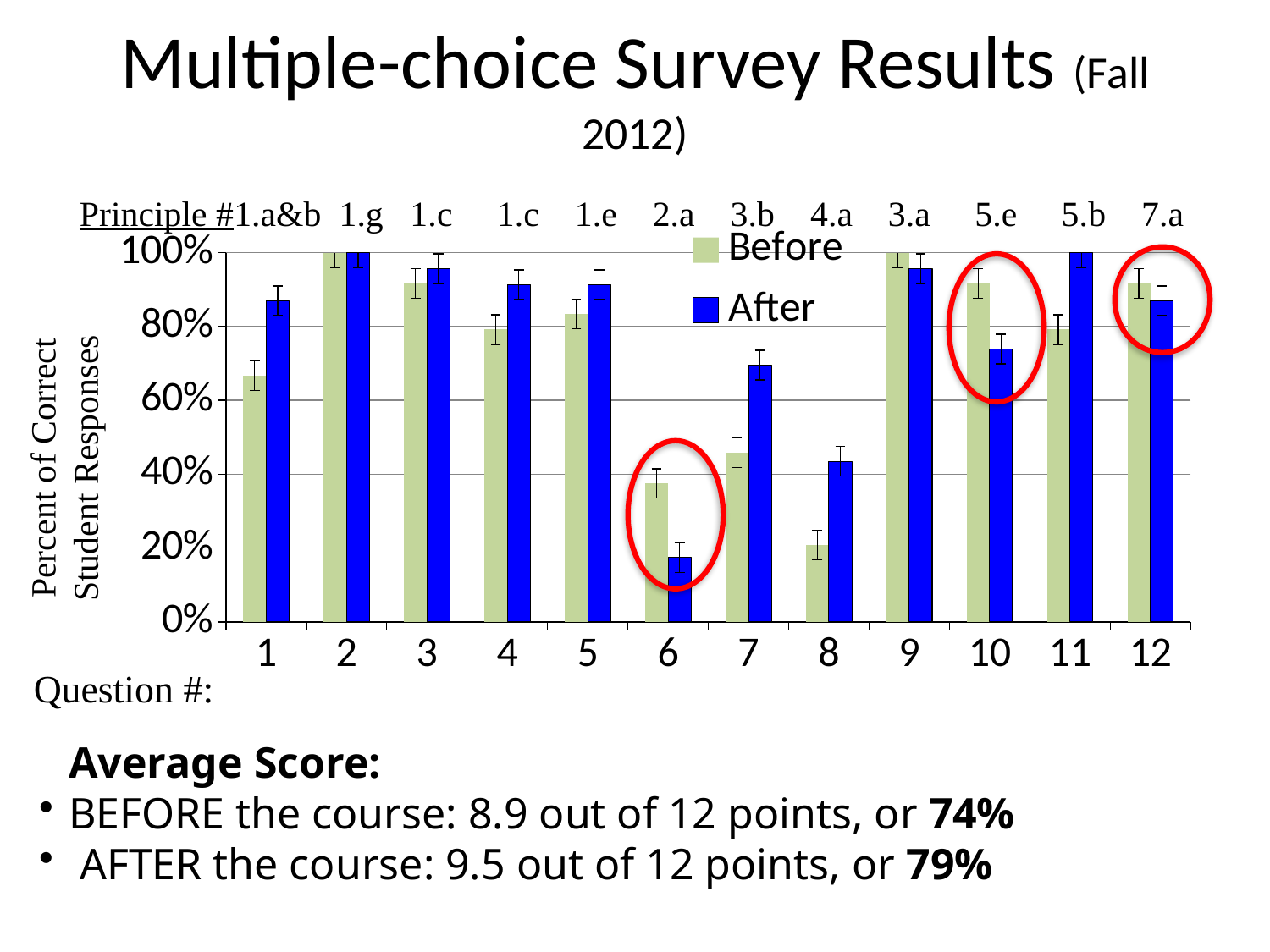
What is the y-axis title of the chart? Percent of Correct Student Responses What kind of chart is shown on the slide? bar chart For question 7, which is larger, the Before value or the After value? After Which question has the lowest Before value? 8 For question 10, which is larger, the Before value or the After value? Before Which question has the lowest After value? 6 Is the After value for question 10 greater or less than 80%? less How many questions are shown along the x axis of the chart? 12 What are the two series named in the chart's legend? Before and After How many series does the chart's legend list? 2 Is the Before value for question 1 greater or less than 60%? greater Is the After value for question 6 greater or less than 20%? less